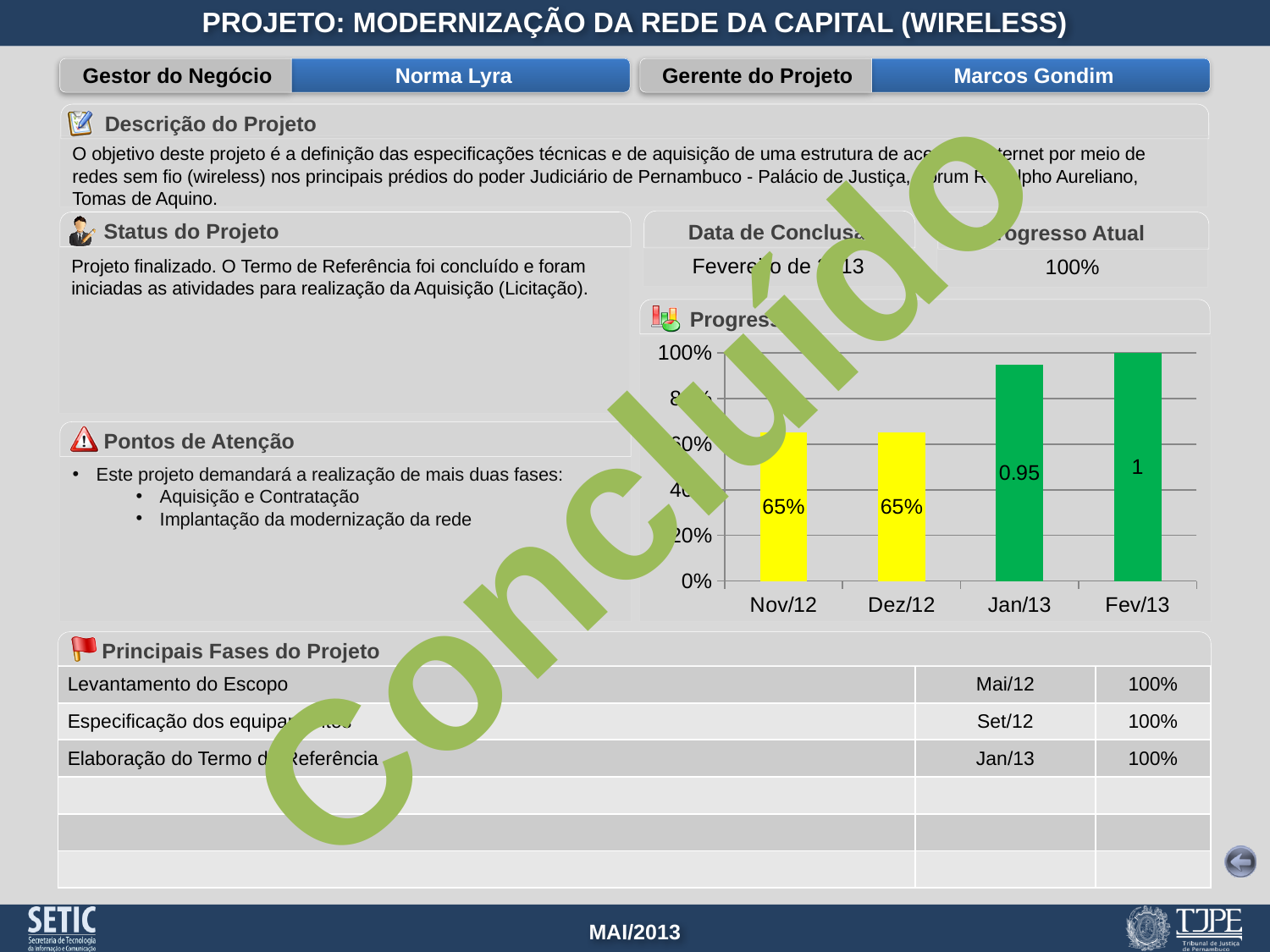
In the progress chart, which bar is taller: Dez/12 or Jan/13? Jan/13 What is the difference between the data labels of the Fev/13 and Jan/13 bars in the progress chart? 0.05 What colour are the Nov/12 and Dez/12 bars in the progress chart? yellow Is the value for Nov/12 in the progress chart greater or less than 80%? less How many months are shown on the x axis of the progress chart? 4 What is the value shown for Nov/12 in the progress chart? 65% What is the data label on the Jan/13 bar in the progress chart? 0.95 Which month has the highest bar in the progress chart? Fev/13 What is the value shown for Dez/12 in the progress chart? 65% What kind of chart is used to show the project progress? bar chart Do the values in the progress chart rise or fall from Nov/12 to Fev/13? rise What is the data label on the Fev/13 bar in the progress chart? 1